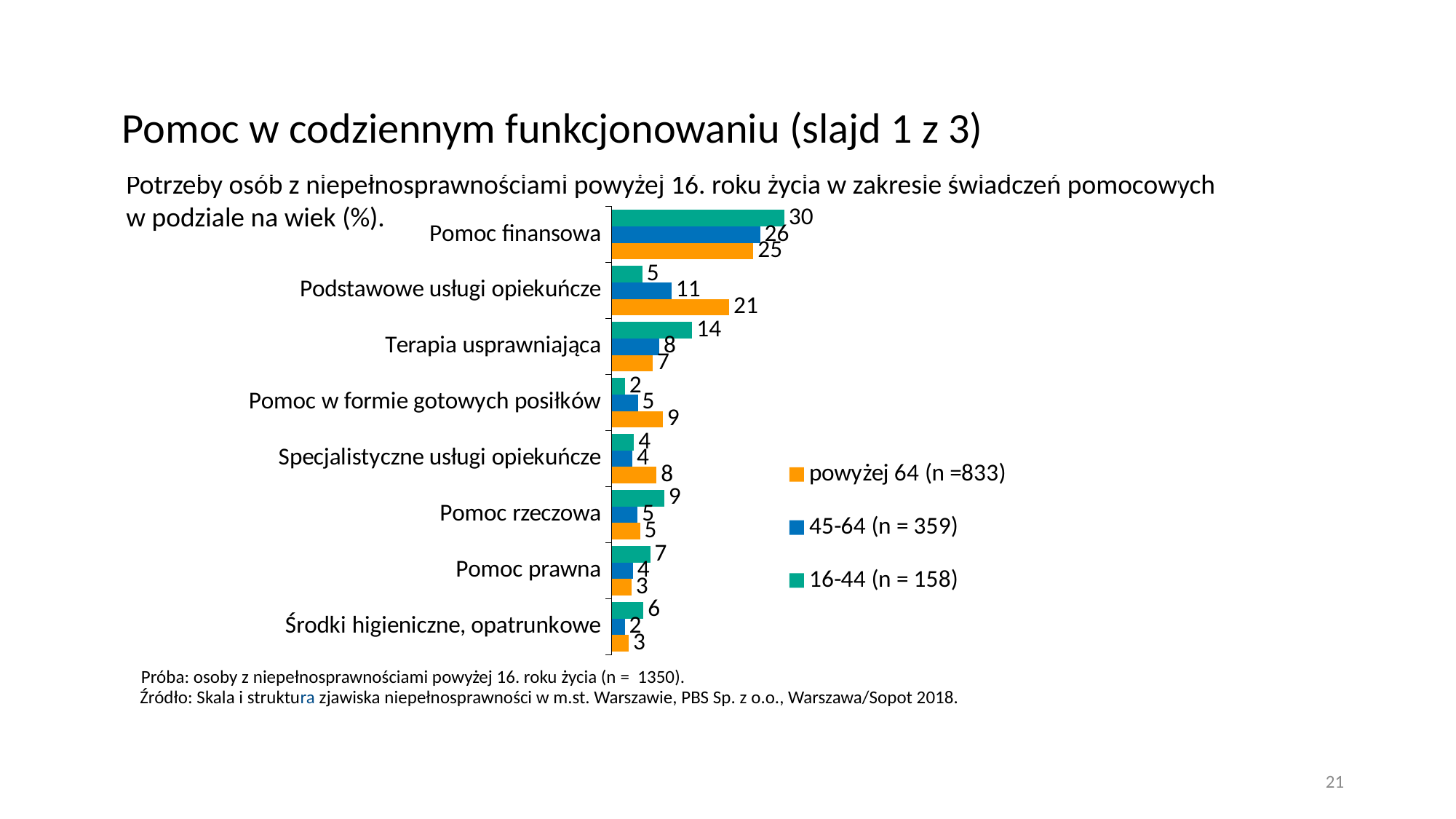
What is the value for 'Pomoc finansowa' in the 16-44 (n = 158) series? 30 Which category has the highest value in the powyżej 64 (n =833) series? Pomoc finansowa How many categories are shown on the chart? 8 Which category has the lowest value in the 16-44 (n = 158) series? Pomoc w formie gotowych posiłków What is the difference between the powyżej 64 and 16-44 values for 'Podstawowe usługi opiekuńcze'? 16 What is the value for 'Terapia usprawniająca' in the 45-64 (n = 359) series? 8 For 'Pomoc w formie gotowych posiłków', which series has the larger value: powyżej 64 (n =833) or 16-44 (n = 158)? powyżej 64 (n =833) Which colour represents the 45-64 (n = 359) series in the legend? blue How many series does the legend list? 3 What is the value for 'Podstawowe usługi opiekuńcze' in the powyżej 64 (n =833) series? 21 What type of chart is shown on the slide? bar chart What is the difference between the 16-44 and 45-64 values for 'Pomoc finansowa'? 4